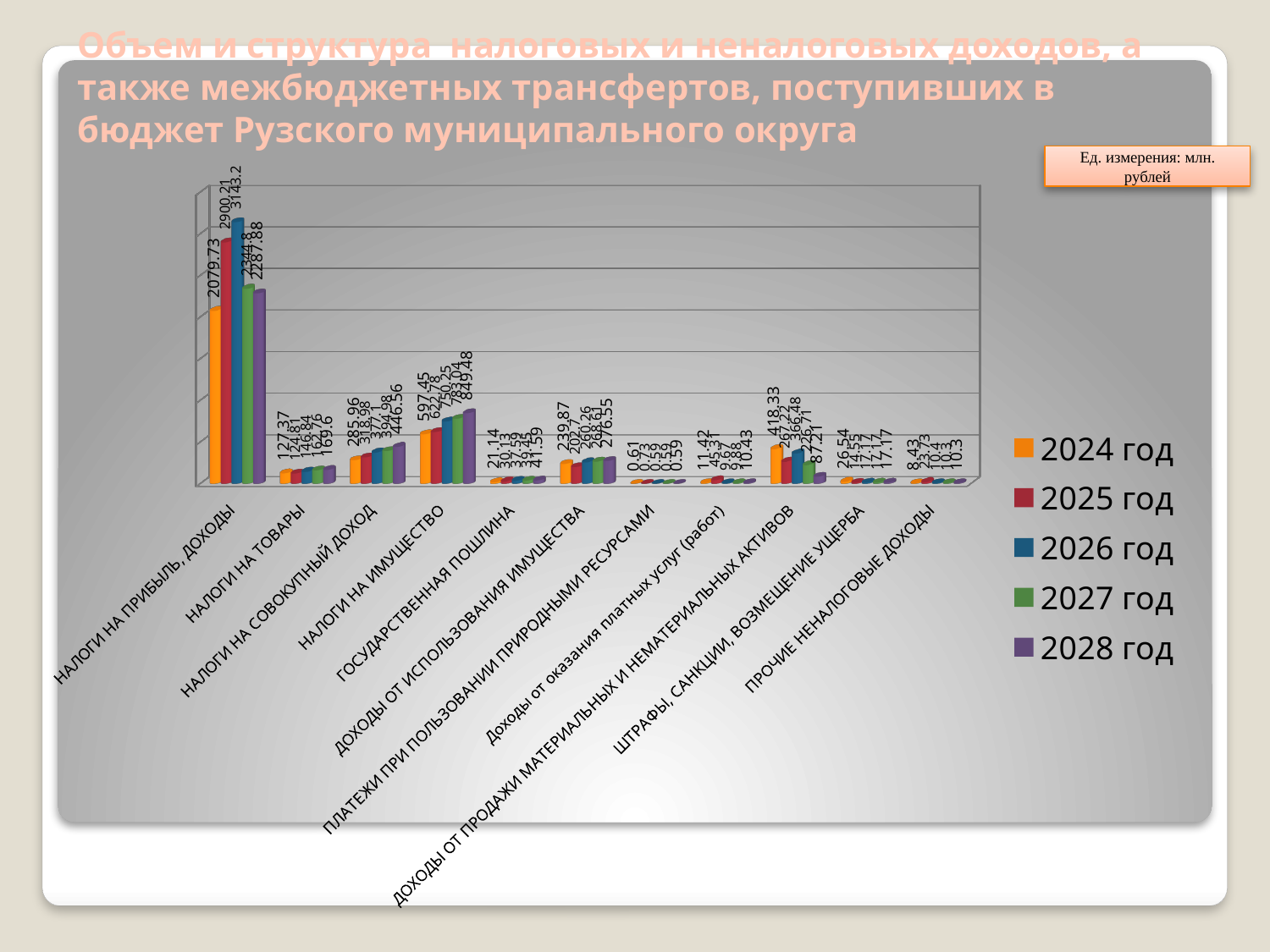
What is the value for НАЛОГИ НА ИМУЩЕСТВО in 2028 год? 849.48 For ДОХОДЫ ОТ ПРОДАЖИ МАТЕРИАЛЬНЫХ И НЕМАТЕРИАЛЬНЫХ АКТИВОВ, which is larger: the 2024 год value or the 2028 год value? 2024 год What is the difference between the 2026 год and 2024 год values for НАЛОГИ НА ПРИБЫЛЬ, ДОХОДЫ? 1063.47 Do the values for НАЛОГИ НА ИМУЩЕСТВО rise or fall from 2024 год to 2028 год? Rise What unit of measurement is stated for the chart values? млн. рублей What is the value for НАЛОГИ НА ПРИБЫЛЬ, ДОХОДЫ in 2024 год? 2079.73 What kind of chart is shown on the slide? Bar chart Which category has the highest value in 2024 год? НАЛОГИ НА ПРИБЫЛЬ, ДОХОДЫ Which year has the highest value for НАЛОГИ НА ПРИБЫЛЬ, ДОХОДЫ? 2026 год How many categories are shown along the x axis of the chart? 11 What is the value for НАЛОГИ НА ПРИБЫЛЬ, ДОХОДЫ in 2026 год? 3143.2 How many series does the legend list? 5